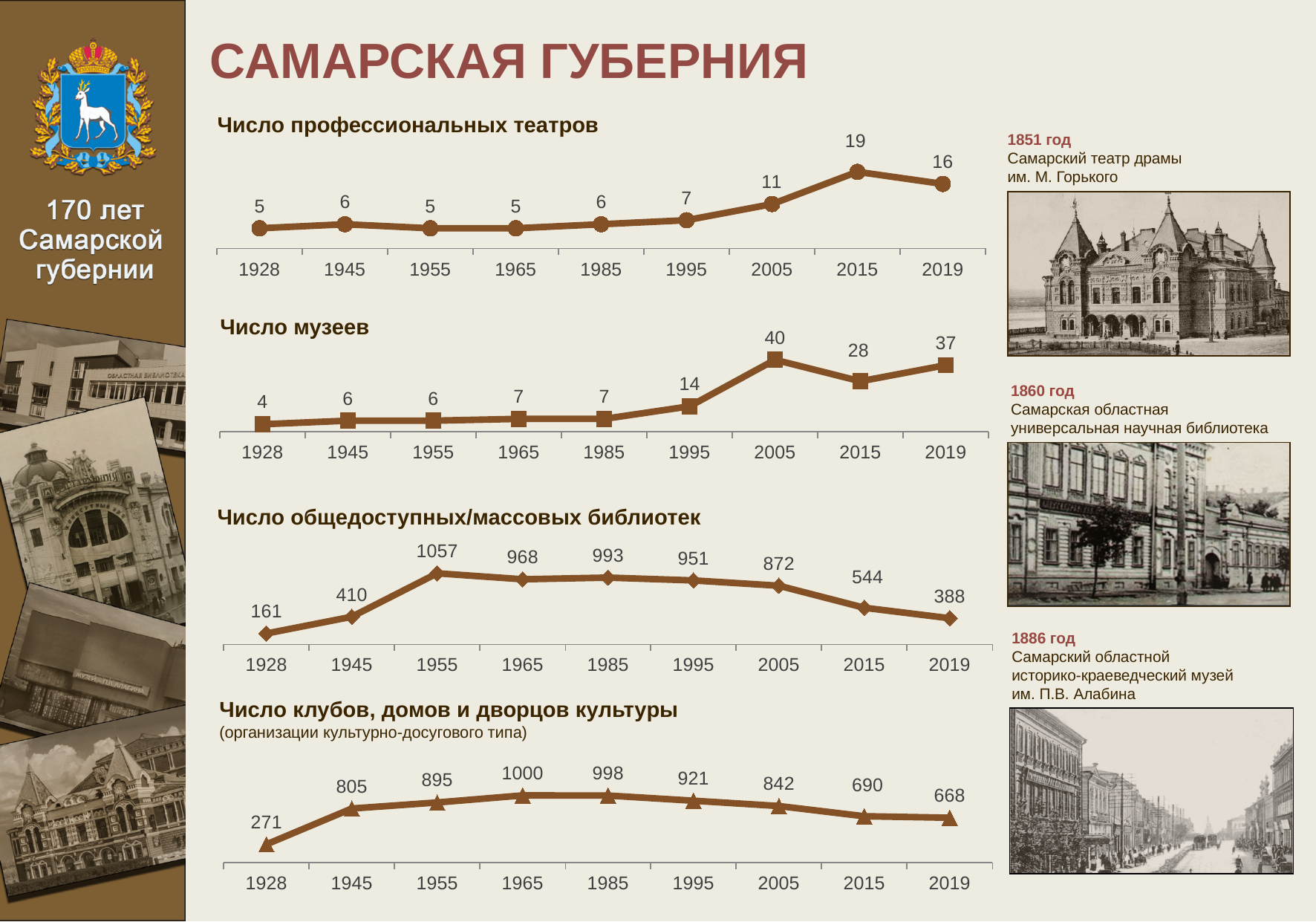
In the chart "Число музеев", which year has the lowest value? 1928 In the chart "Число музеев", what is the value for 2005? 40 In the chart "Число общедоступных/массовых библиотек", which is larger, the value for 1965 or the value for 1985? 1985 What type of chart is "Число профессиональных театров"? line chart In the chart "Число музеев", what is the difference between the values for 2019 and 2015? 9 In the chart "Число клубов, домов и дворцов культуры", do the values rise or fall from 1985 to 2019? fall In the chart "Число общедоступных/массовых библиотек", what is the value for 1955? 1057 In the chart "Число профессиональных театров", which year has the highest value? 2015 How many data points are plotted in the chart "Число клубов, домов и дворцов культуры"? 9 In the chart "Число клубов, домов и дворцов культуры", what is the value for 1965? 1000 In the chart "Число общедоступных/массовых библиотек", what is the difference between the values for 2015 and 2019? 156 In the chart "Число профессиональных театров", what is the value for 2015? 19